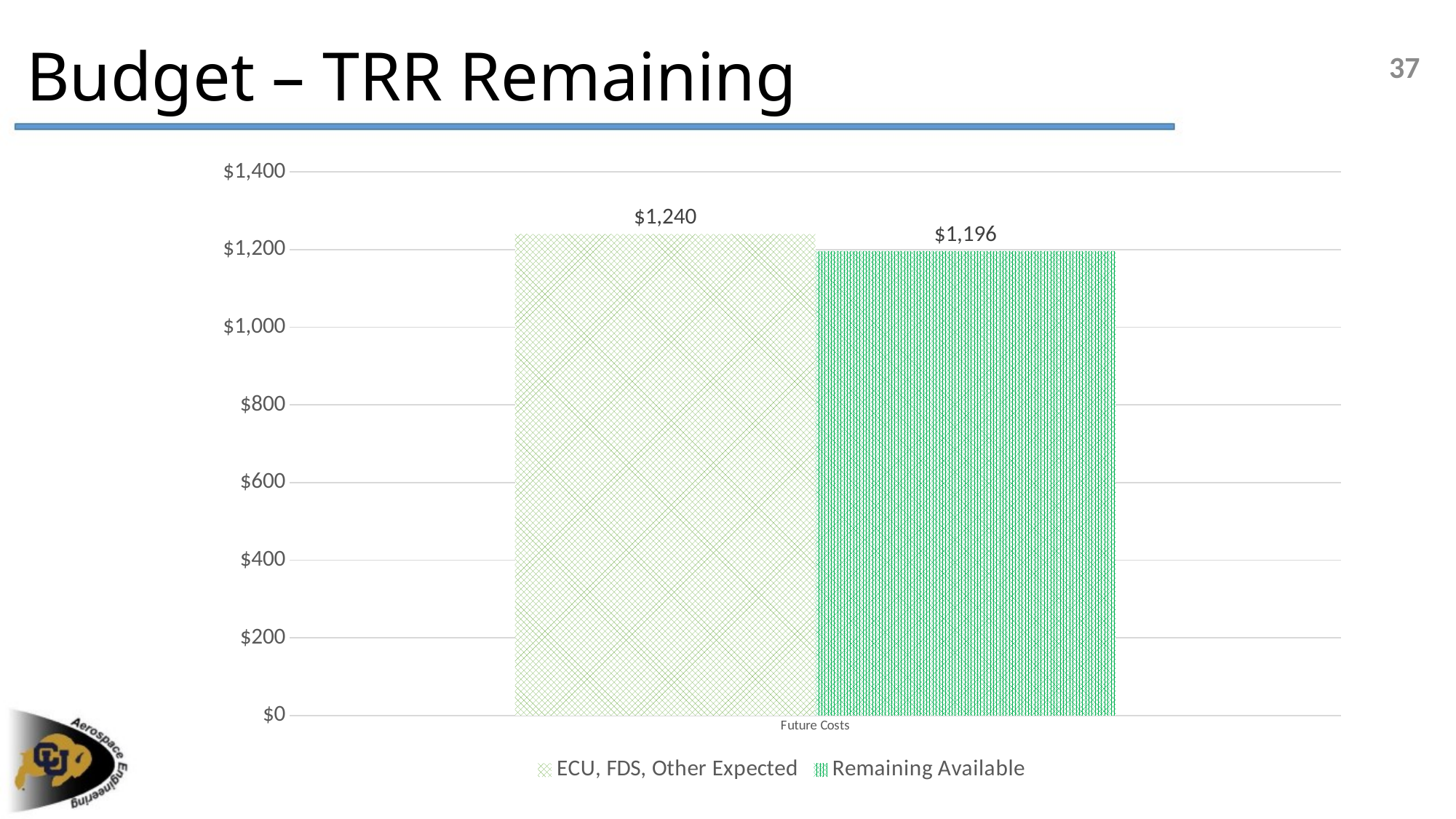
How many series does the legend list? 2 Is the value for ECU, FDS, Other Expected greater or less than $1,400? less Which series has the higher value? ECU, FDS, Other Expected What is the difference between the ECU, FDS, Other Expected value and the Remaining Available value? $44 What is the value of the Remaining Available bar? $1,196 Which series has the lower value? Remaining Available What is the title of the slide containing the chart? Budget – TRR Remaining What kind of chart is shown on the slide? bar chart What is the category label on the x axis? Future Costs Is the value for Remaining Available greater or less than $1,000? greater Is the Remaining Available value larger or smaller than the ECU, FDS, Other Expected value? smaller What is the value of the ECU, FDS, Other Expected bar? $1,240